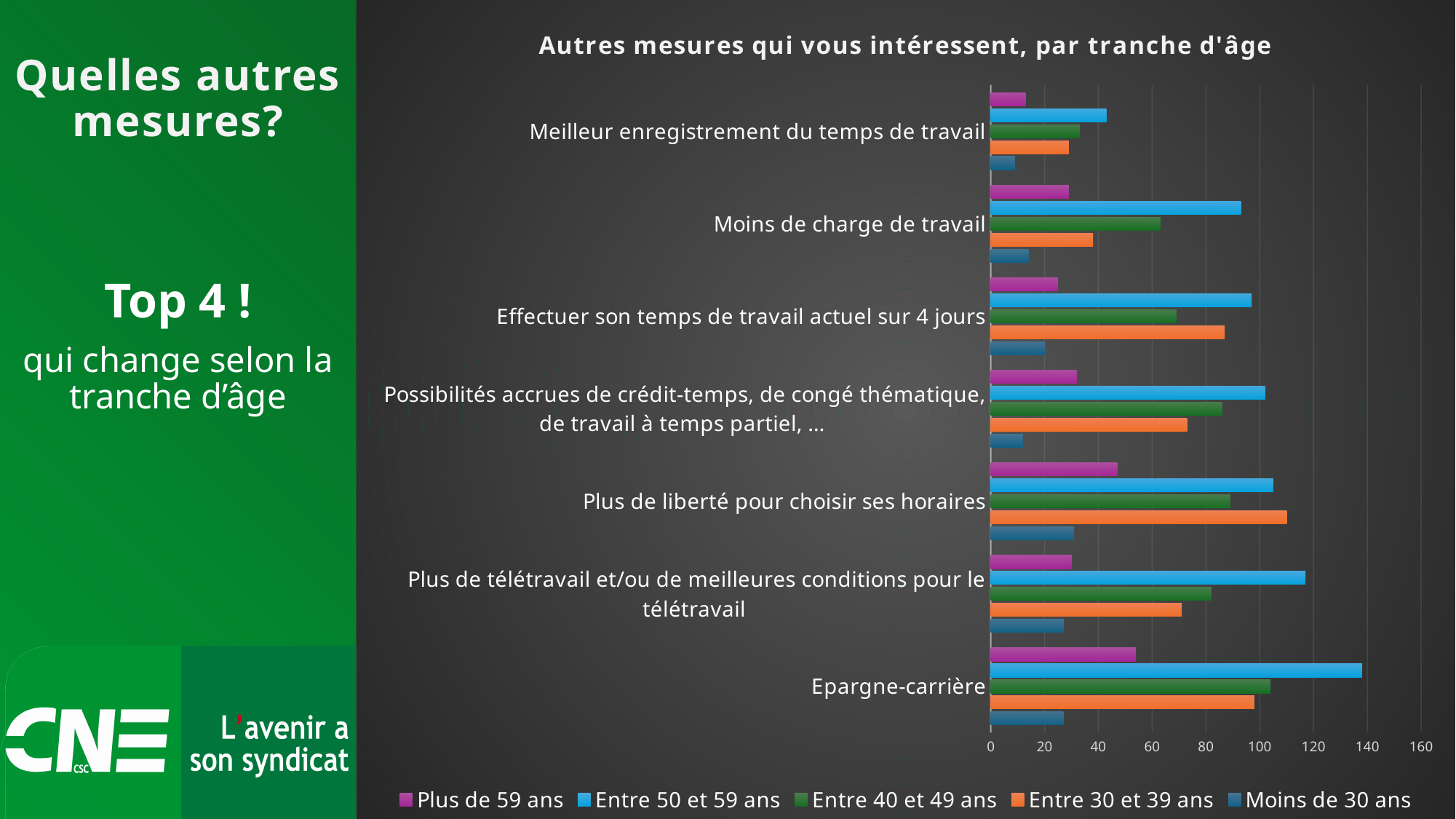
Which colour represents the series 'Entre 30 et 39 ans' in the legend? orange How many measure categories are plotted on the chart? 7 For the series 'Entre 50 et 59 ans', which category has the highest value? Epargne-carrière For 'Epargne-carrière', which age group has the lowest value? Moins de 30 ans What is the title of the chart? Autres mesures qui vous intéressent, par tranche d'âge How many series does the legend list? 5 For the series 'Entre 50 et 59 ans', which category has the lowest value? Meilleur enregistrement du temps de travail What kind of chart is shown on the slide? bar chart Is the value for 'Entre 50 et 59 ans' on 'Moins de charge de travail' greater or less than 80? greater Is the value for 'Entre 50 et 59 ans' on 'Epargne-carrière' greater or less than 120? greater For 'Effectuer son temps de travail actuel sur 4 jours', which is larger: the value for 'Entre 30 et 39 ans' or for 'Entre 40 et 49 ans'? Entre 30 et 39 ans For 'Epargne-carrière', which age group has the highest value? Entre 50 et 59 ans